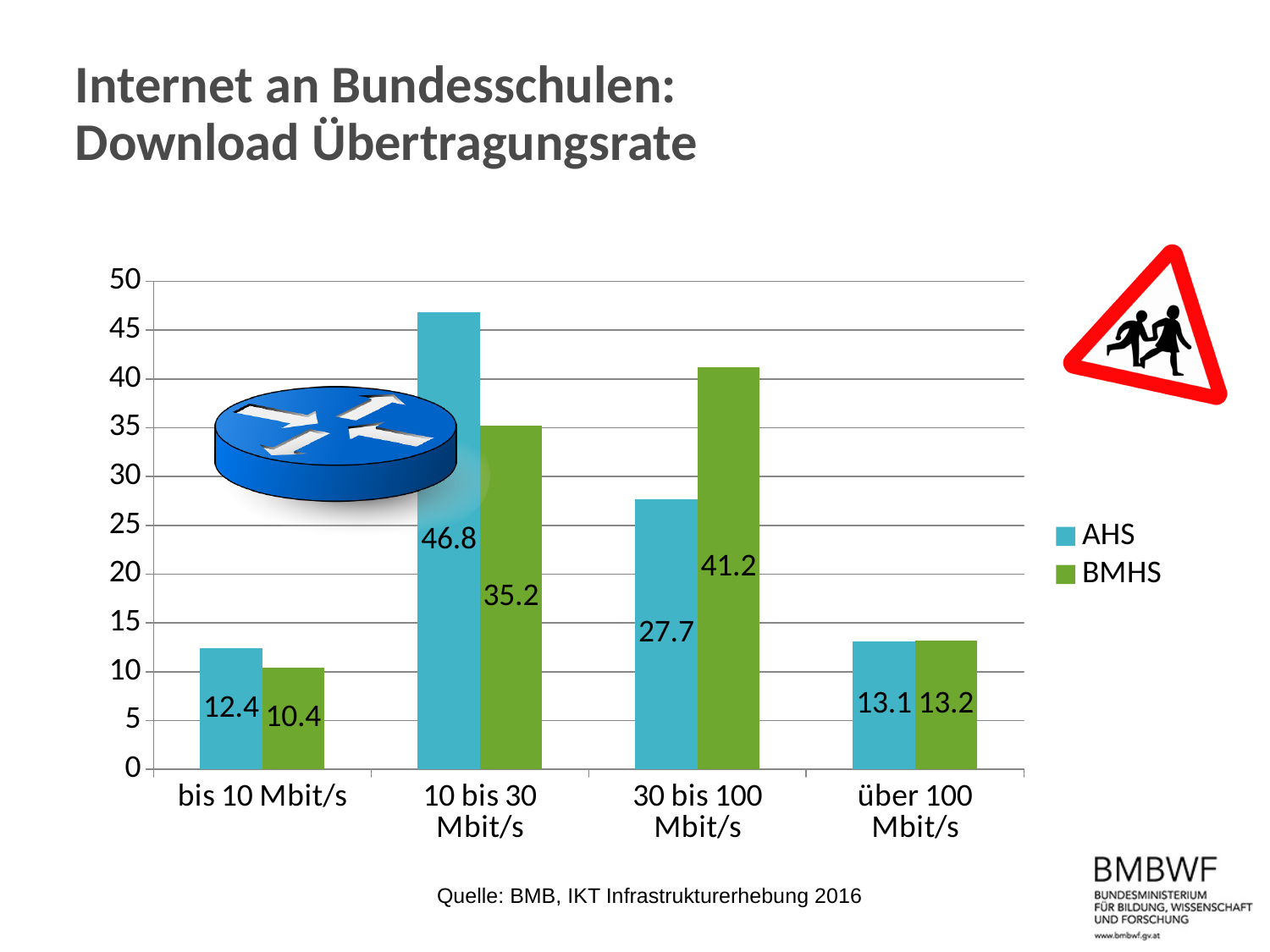
What is the AHS value for the '10 bis 30 Mbit/s' category? 46.8 Which series is shown in green in the legend? BMHS What is the difference between the AHS and BMHS values in the '10 bis 30 Mbit/s' category? 11.6 What is the BMHS value for the '30 bis 100 Mbit/s' category? 41.2 Which category has the highest AHS value? 10 bis 30 Mbit/s Which category has the lowest BMHS value? bis 10 Mbit/s How many categories are shown on the x axis? 4 What kind of chart is shown on the slide? bar chart What is the BMHS value for the 'bis 10 Mbit/s' category? 10.4 In the '30 bis 100 Mbit/s' category, which series has the larger value, AHS or BMHS? BMHS Is the AHS value for '30 bis 100 Mbit/s' greater or less than 25? greater How many series does the legend list? 2